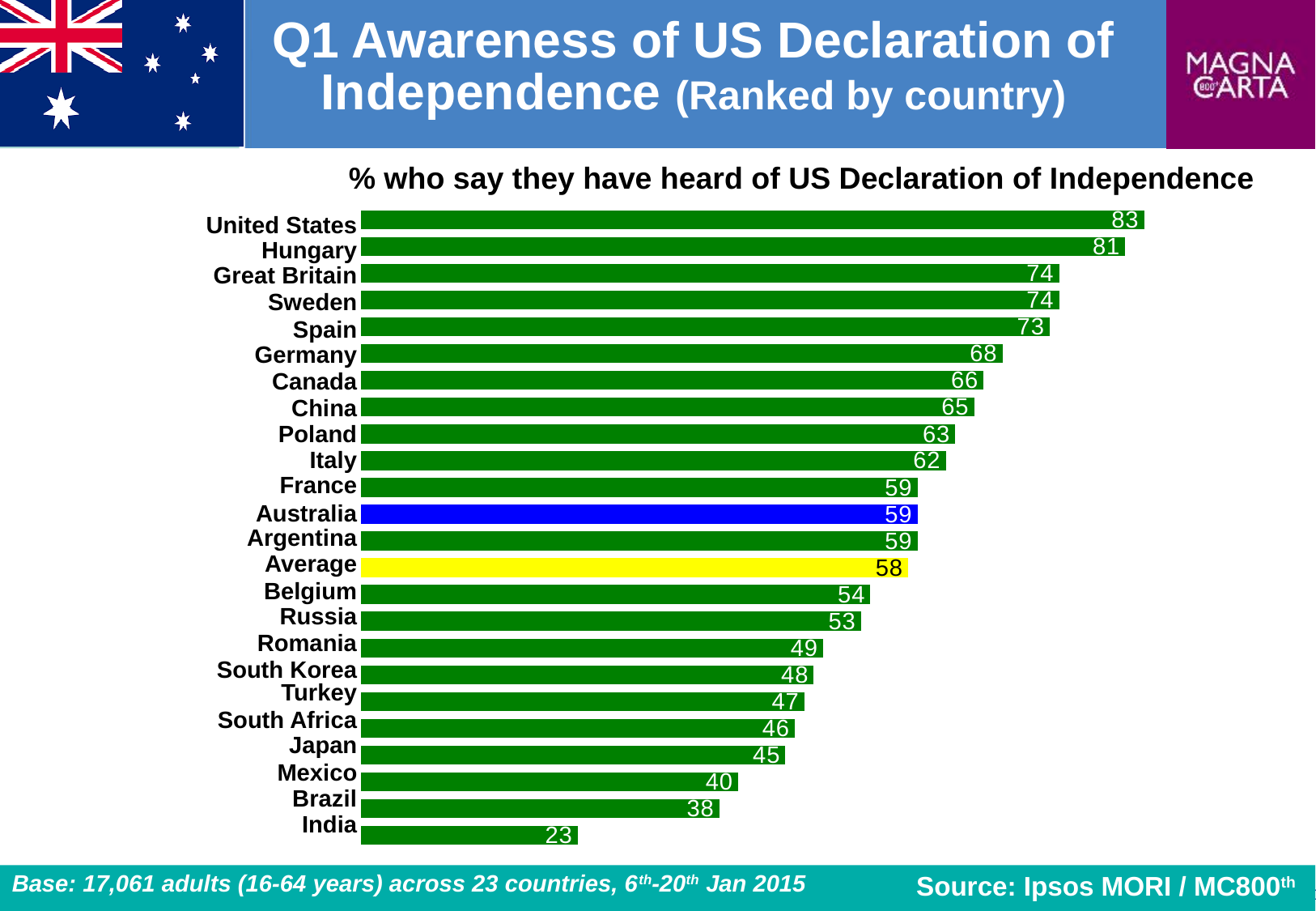
What colour is the Australia bar? Blue What is the difference between the values for the United States and India? 60 How many bars are plotted in the chart, including the Average bar? 24 Which has a larger value, Japan or Mexico? Japan Which country has the lowest value? India Which has a larger value, Canada or Belgium? Canada What kind of chart is shown on the slide? Bar chart What is the value for Australia? 59 What is the value shown for the Average bar? 58 What is the value for the United States? 83 What is the difference between the values for Hungary and Germany? 13 Which country has the highest value? United States